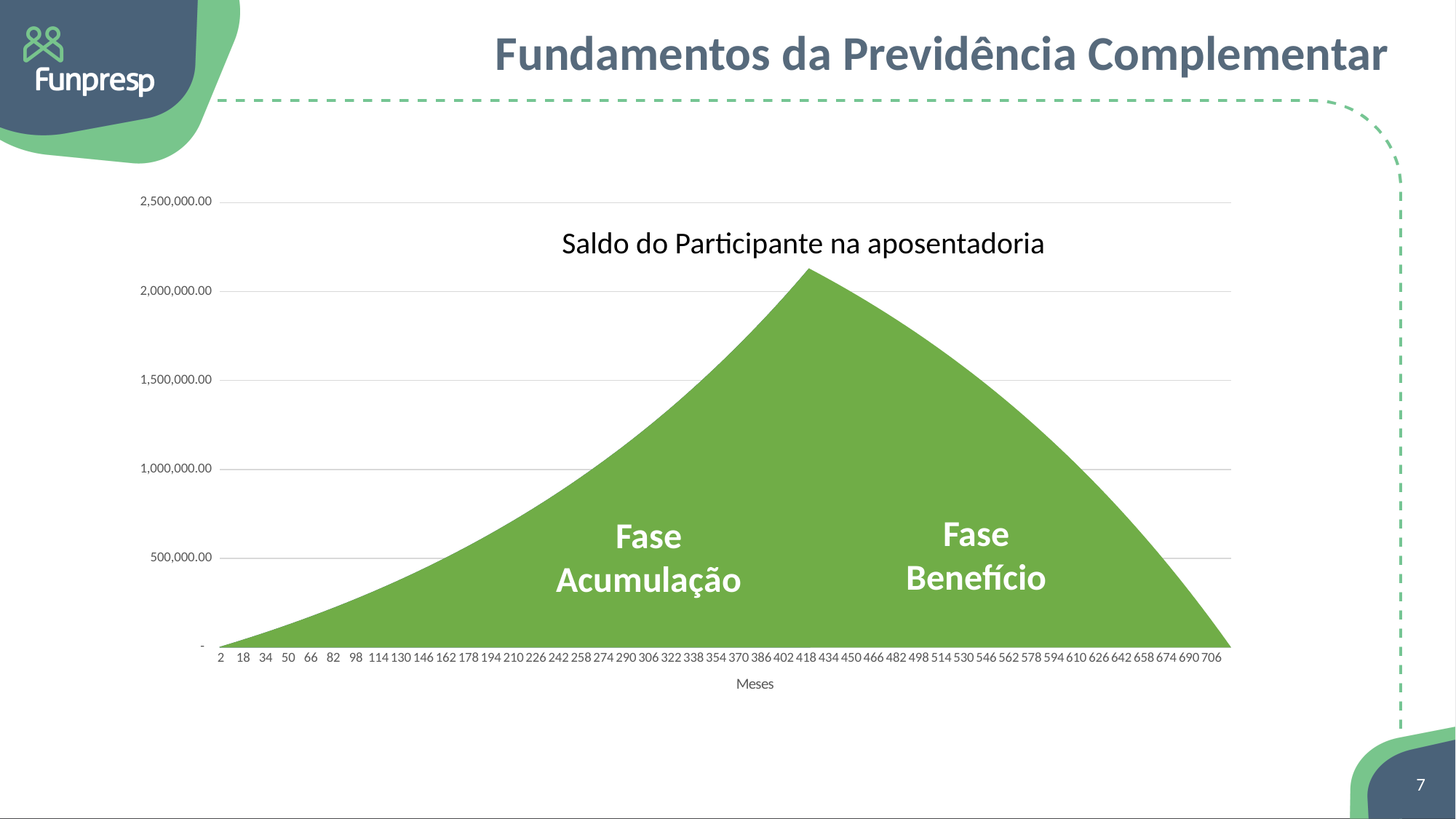
Between month 418 and month 706, does the balance rise or fall? fall What is the highest value shown on the y axis? 2,500,000.00 Is the value at month 210 greater or less than 1,000,000.00? less What is the title of the chart? Saldo do Participante na aposentadoria Is the value at month 706 greater or less than 500,000.00? less What kind of chart is shown on the slide? Area chart Between month 2 and month 418, does the balance rise or fall? rise Is the peak value of the balance greater or less than 2,000,000.00? greater What is the label of the x axis? Meses